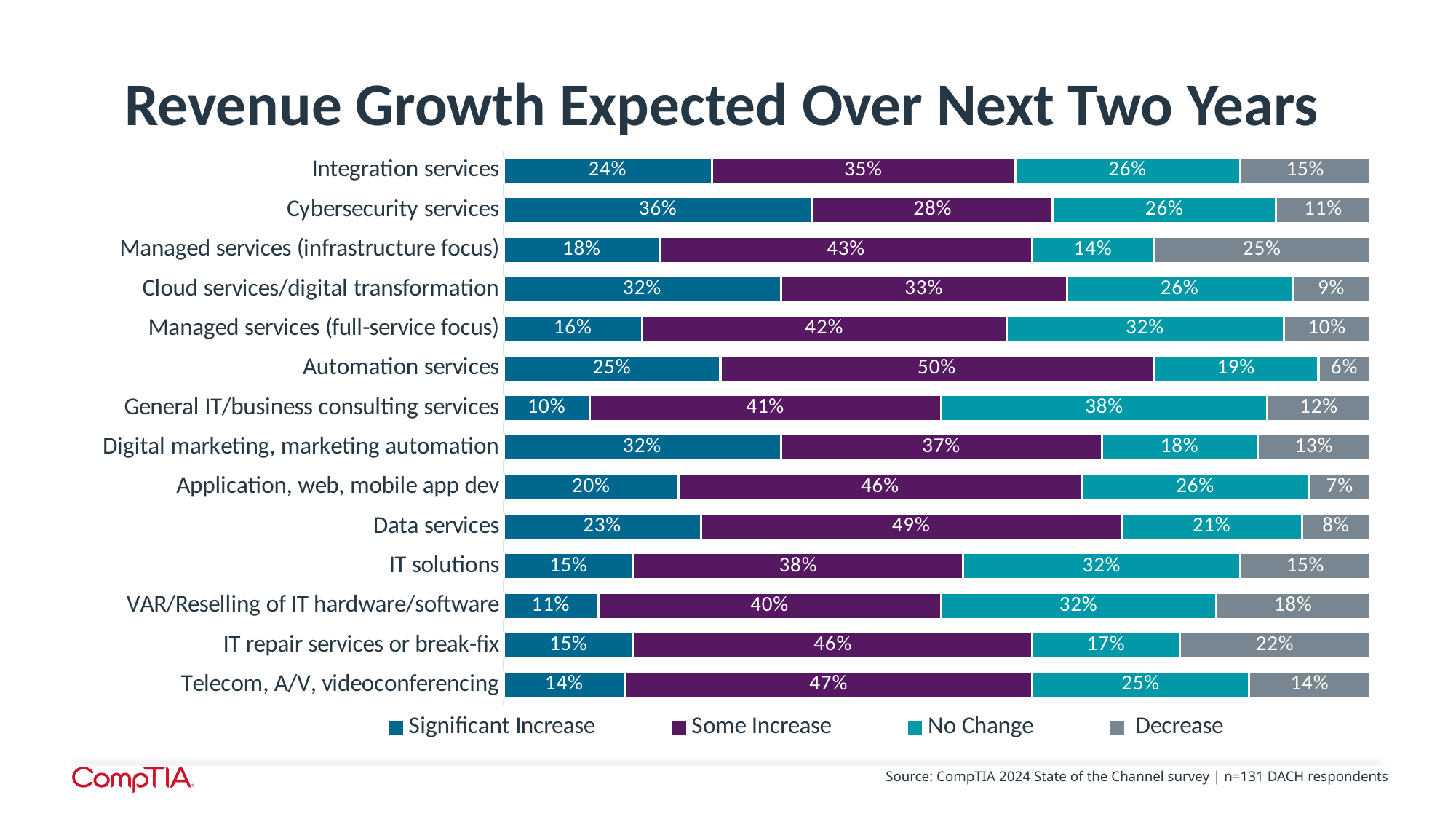
Which is larger: the Significant Increase value for Cloud services/digital transformation or for Integration services? Cloud services/digital transformation How many series does the legend list? 4 How many service categories are plotted in the chart? 14 Which category has the lowest Significant Increase value? General IT/business consulting services What is the combined Significant Increase and Some Increase share for Integration services? 59% What kind of chart is shown on the slide? stacked bar chart What is the difference between the Some Increase values for Data services and Integration services? 14% What is the No Change value for General IT/business consulting services? 38% Which category has the highest Some Increase value? Automation services Which category has the lowest Decrease value? Automation services What is the Significant Increase value for Cybersecurity services? 36% What is the Decrease value for Managed services (infrastructure focus)? 25%